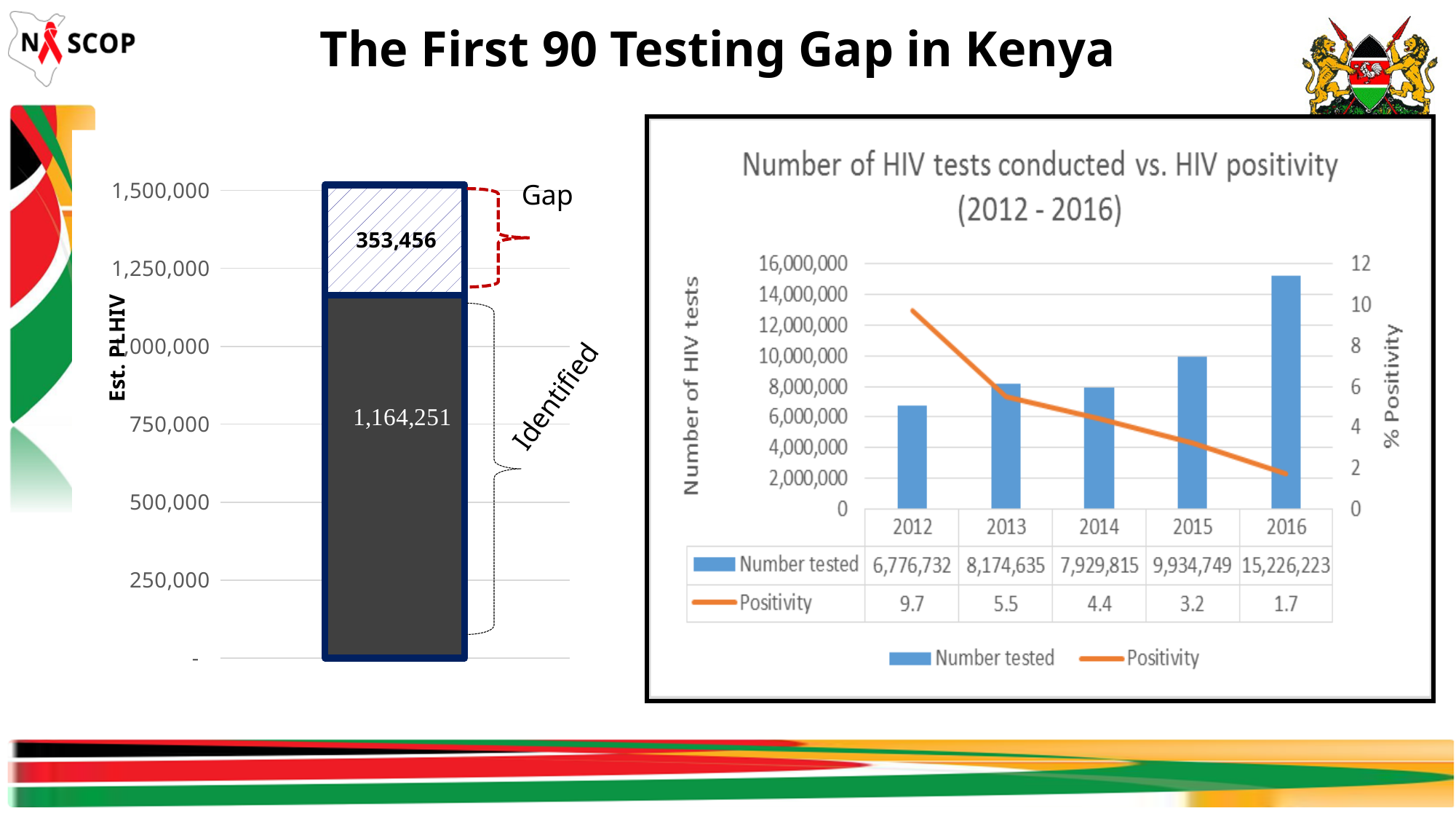
In the chart 'Number of HIV tests conducted vs. HIV positivity (2012 - 2016)', how does positivity change from 2012 to 2016? It falls In the left chart (Est. PLHIV), what is the value of the Identified segment? 1,164,251 In the chart 'Number of HIV tests conducted vs. HIV positivity (2012 - 2016)', what was the positivity in 2013? 5.5 In the chart 'Number of HIV tests conducted vs. HIV positivity (2012 - 2016)', which year had the highest number tested? 2016 In the left chart (Est. PLHIV), which segment is larger, Gap or Identified? Identified In the chart 'Number of HIV tests conducted vs. HIV positivity (2012 - 2016)', how many series does the legend list? 2 In the chart 'Number of HIV tests conducted vs. HIV positivity (2012 - 2016)', how many years are shown on the x axis? 5 In the chart 'Number of HIV tests conducted vs. HIV positivity (2012 - 2016)', what is the difference in number tested between 2016 and 2015? 5,291,474 In the left chart (Est. PLHIV), what is the value of the Gap segment? 353,456 In the chart 'Number of HIV tests conducted vs. HIV positivity (2012 - 2016)', which year had the lowest positivity? 2016 In the chart 'Number of HIV tests conducted vs. HIV positivity (2012 - 2016)', how many tests were conducted in 2014? 7,929,815 In the left chart (Est. PLHIV), what is the total of the stacked bar (Gap plus Identified)? 1,517,707